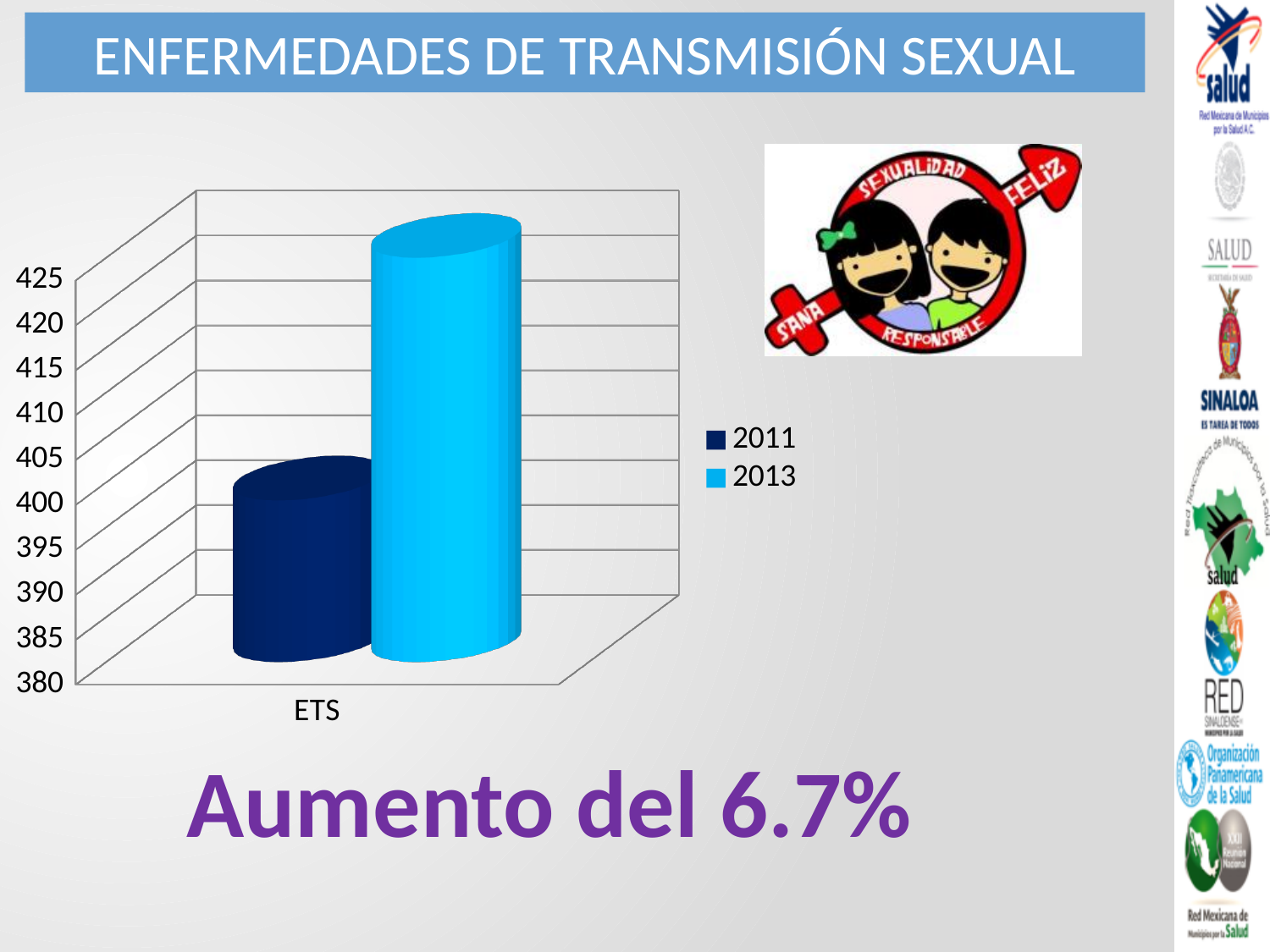
Which series has the taller bar for ETS, 2011 or 2013? 2013 How many categories are shown on the x axis of the chart? 1 What kind of chart is shown on the slide? bar chart Is the value for 2011 greater or less than 390? greater Is the value for 2011 greater or less than 410? less Is the value for 2013 greater or less than 415? greater How many series does the chart legend list? 2 Which years are listed in the chart legend? 2011 and 2013 What is the label of the category on the x axis? ETS Did the value for ETS rise or fall from 2011 to 2013? rise What is the lowest value shown on the vertical axis of the chart? 380